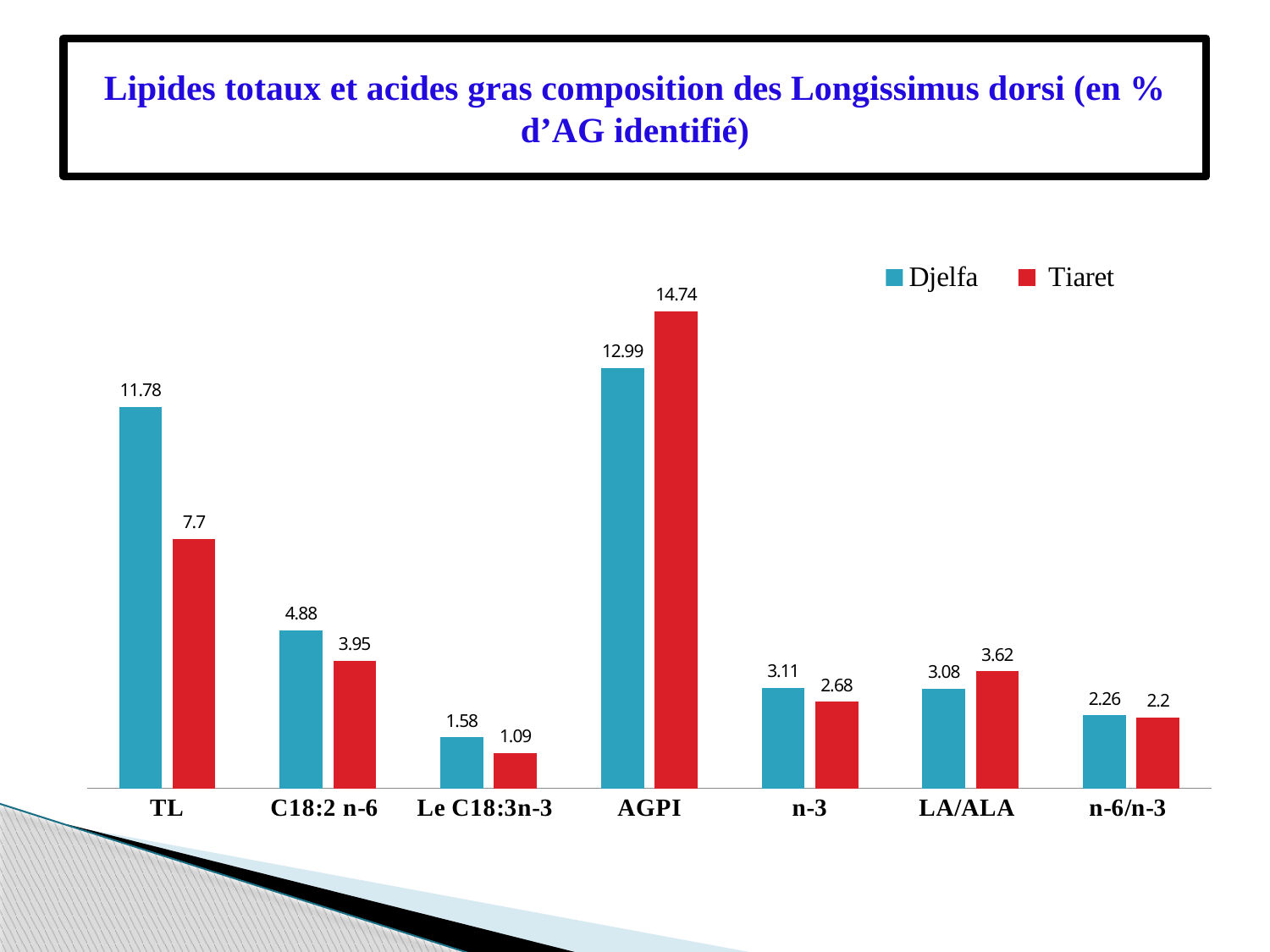
What is the Djelfa value for TL? 11.78 Which category has the lowest Tiaret value? Le C18:3n-3 How many series does the legend list? 2 What is the difference between the Djelfa and Tiaret values for TL? 4.08 What kind of chart is shown on the slide? bar chart Which series is shown in red in the legend? Tiaret Which category has the highest Djelfa value? AGPI What is the Tiaret value for C18:2 n-6? 3.95 What is the Djelfa value for LA/ALA? 3.08 How many categories are shown on the x axis? 7 What is the Tiaret value for AGPI? 14.74 Which is larger for LA/ALA, the Djelfa value or the Tiaret value? Tiaret